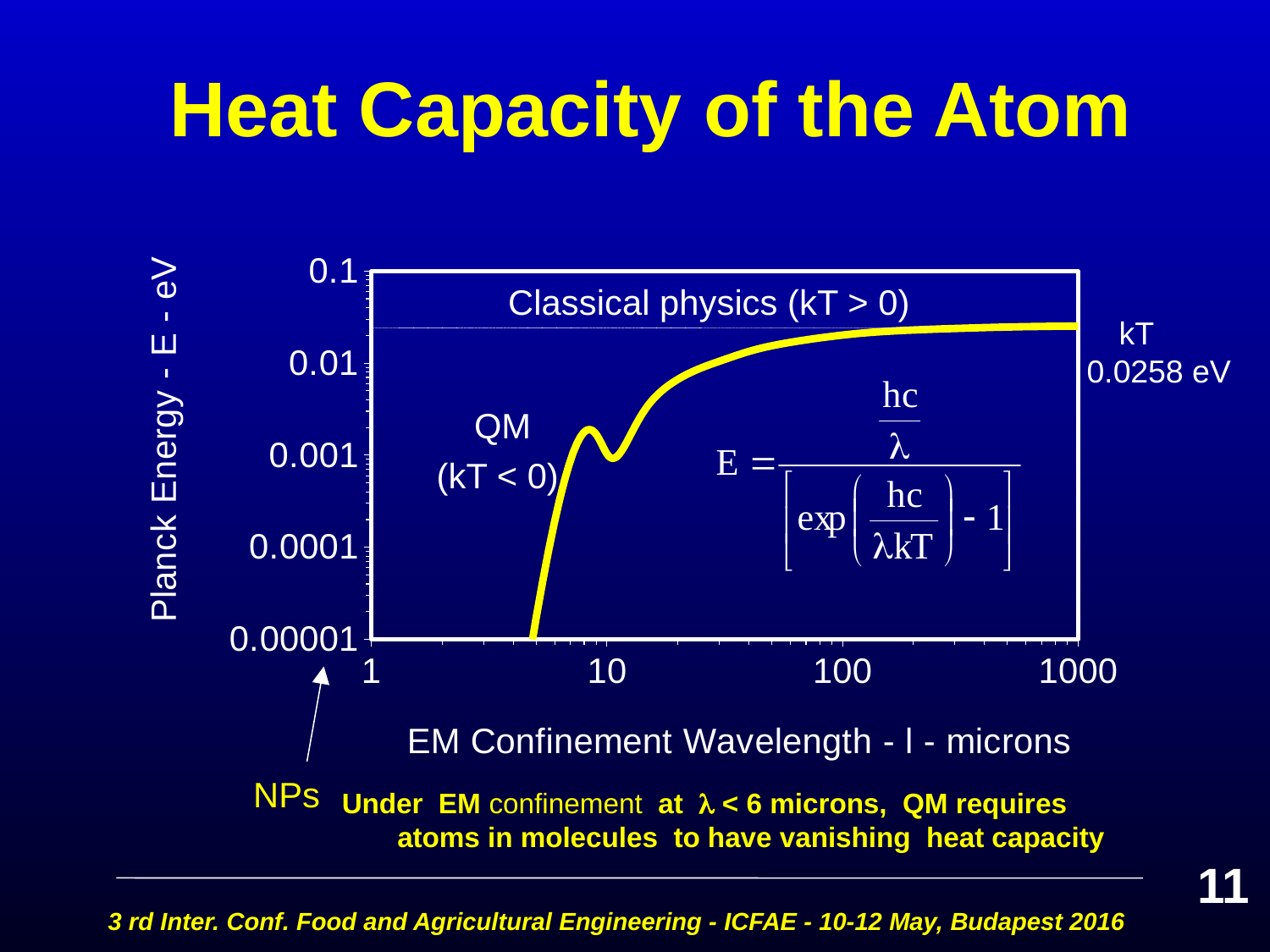
What is the label of the y axis of the chart? Planck Energy - E - eV What is the lowest tick value shown on the y axis? 0.00001 Is the Planck energy at a wavelength of 1000 microns greater or less than 0.1? less Is the Planck energy at a wavelength of 1000 microns greater or less than 0.01? greater What is the value of kT labelled on the chart? 0.0258 eV Does the Planck energy curve rise or fall as the wavelength increases along the x axis? rise What kind of chart is shown on the slide? line chart What is the label of the x axis of the chart? EM Confinement Wavelength - l - microns What is the highest tick value shown on the x axis? 1000 Which region of the chart is labelled 'Classical physics (kT > 0)': the upper part or the lower part? upper part Is the Planck energy at a wavelength of 5 microns greater or less than 0.0001? less How many curves are plotted on the chart? 1